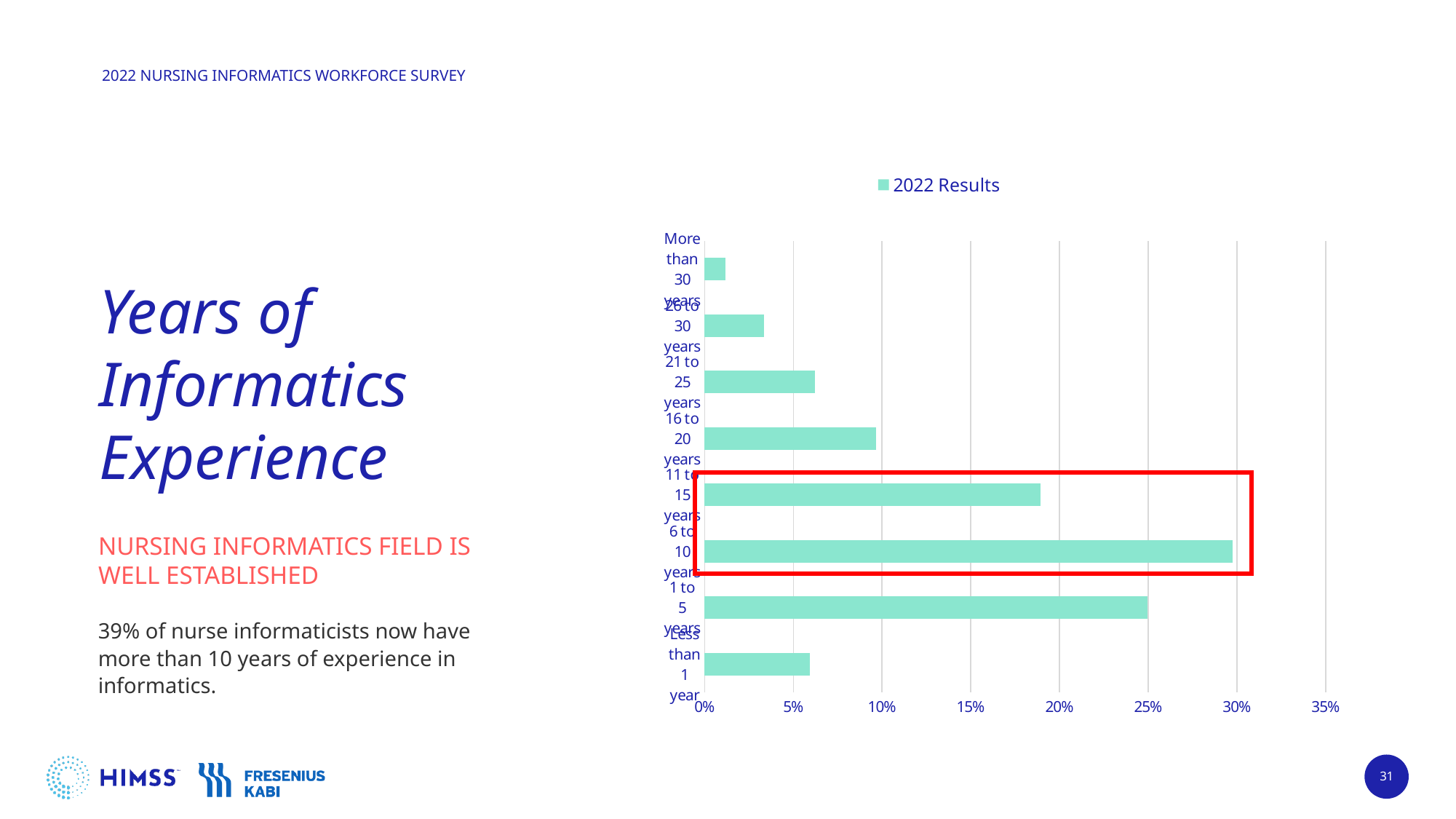
Which has a larger value: 16 to 20 years or 21 to 25 years? 16 to 20 years Is the value for 11 to 15 years greater or less than 20%? less Which experience category has the lowest value in the chart? More than 30 years Is the value for 1 to 5 years greater or less than 20%? greater What kind of chart is shown on the slide? Bar chart Which experience category has the highest value in the chart? 6 to 10 years How many experience categories are plotted in the chart? 8 How many series does the chart legend list? 1 What is the name of the series shown in the chart legend? 2022 Results Which has a larger value: 6 to 10 years or 1 to 5 years? 6 to 10 years Is the value for 26 to 30 years greater or less than 5%? less